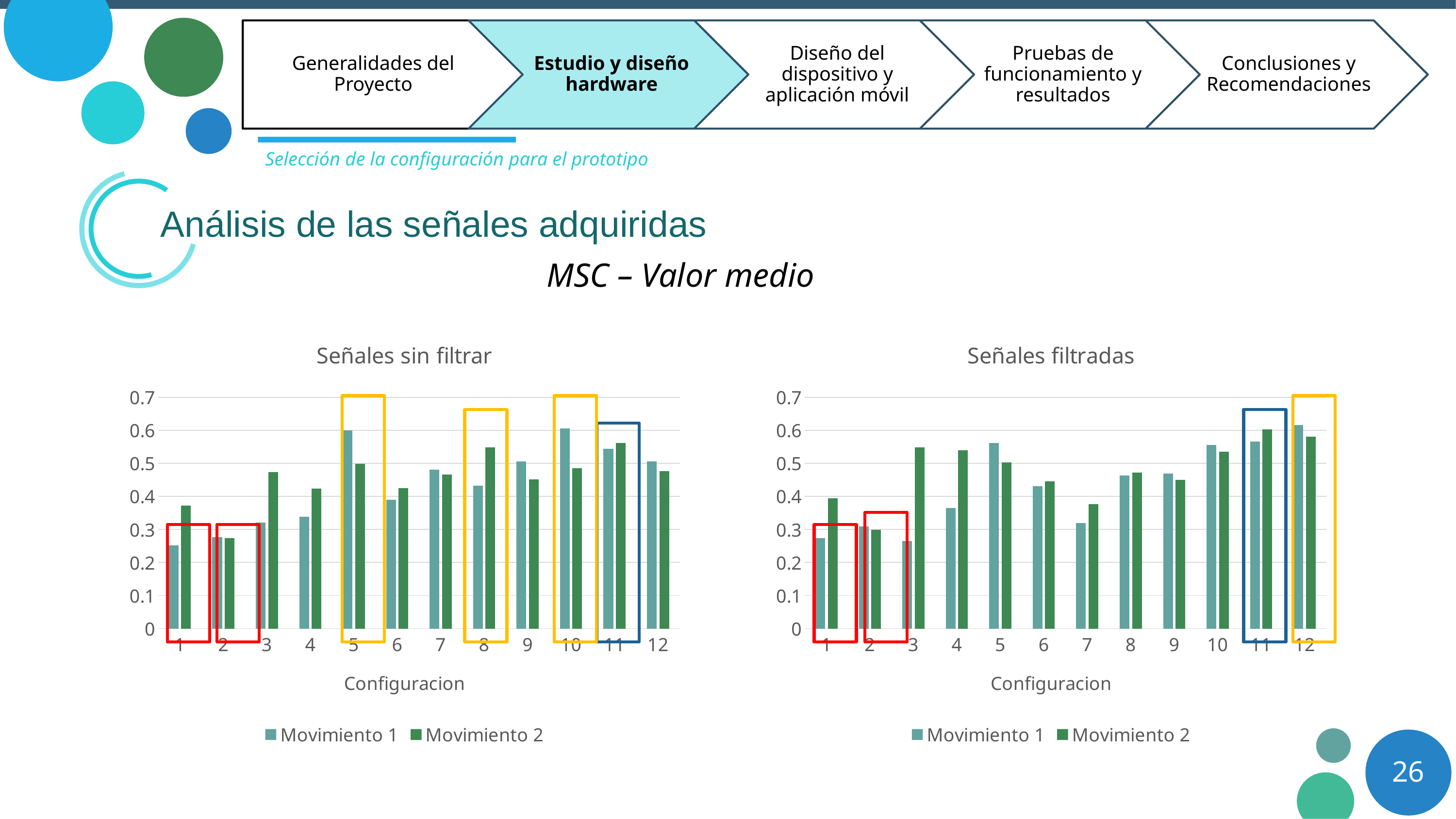
What kind of chart is the 'Señales sin filtrar' chart? bar chart How many series does the legend of the 'Señales sin filtrar' chart list? 2 In the 'Señales filtradas' chart, is the Movimiento 1 value for configuration 4 greater or less than 0.4? less In the 'Señales filtradas' chart, is the Movimiento 2 value for configuration 3 greater or less than 0.5? greater In the 'Señales sin filtrar' chart, is the Movimiento 1 value for configuration 1 greater or less than 0.3? less How many configurations are shown on the x axis of the 'Señales filtradas' chart? 12 What is the x-axis title of the 'Señales filtradas' chart? Configuracion In the 'Señales filtradas' chart, which configuration has the highest Movimiento 1 value? 12 In the 'Señales sin filtrar' chart, which configuration has the lowest Movimiento 2 value? 2 In the 'Señales filtradas' chart, which configuration has the lowest Movimiento 2 value? 2 In the 'Señales sin filtrar' chart, for configuration 1, which series has the larger value, Movimiento 1 or Movimiento 2? Movimiento 2